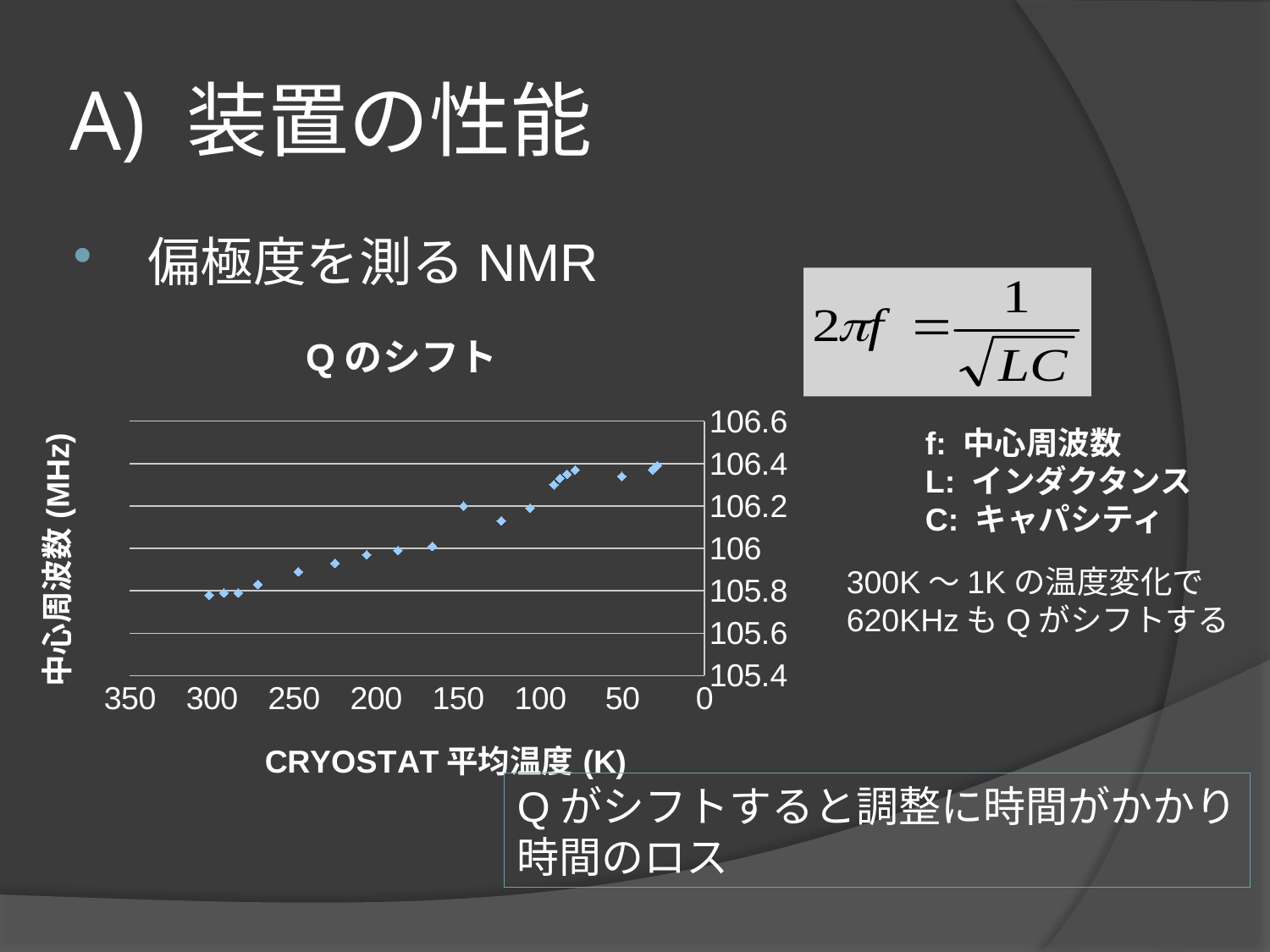
Is the plotted value at 50 K greater or less than 106.2? greater What is the highest tick value shown on the vertical axis? 106.6 What is the title of the chart? Qのシフト Moving from left to right along the x axis (from 350 K toward 0 K), do the plotted values rise or fall? rise Which has the larger plotted value, the point at 250 K or the point at 100 K? 100 K What is the label of the chart's vertical axis? 中心周波数 (MHz) Is the plotted value at 100 K greater or less than 106? greater Which has the larger plotted value, the point at 300 K or the point at 50 K? 50 K What kind of chart is shown on the slide? scatter chart Is the plotted value at 300 K greater or less than 106? less